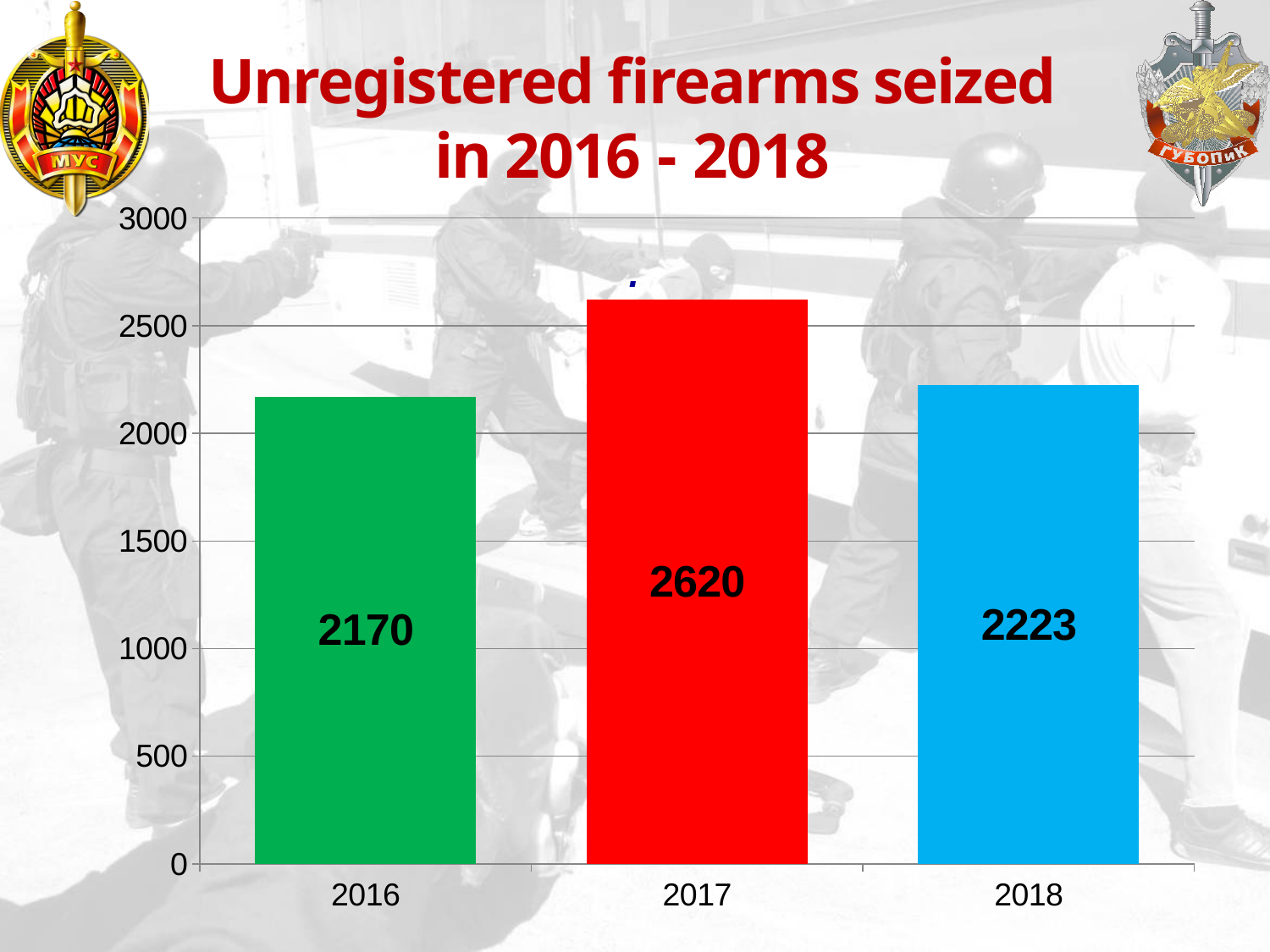
How many unregistered firearms were seized in 2018? 2223 What is the difference between the number of firearms seized in 2017 and in 2016? 450 How many unregistered firearms were seized in 2017? 2620 Which year had more unregistered firearms seized, 2016 or 2018? 2018 Is the value for 2017 greater or less than 2500? greater How many unregistered firearms were seized in 2016? 2170 What is the title of the chart? Unregistered firearms seized in 2016 - 2018 Which year had the lowest number of unregistered firearms seized? 2016 Which year had the highest number of unregistered firearms seized? 2017 What kind of chart is shown on the slide? bar chart What is the difference between the number of firearms seized in 2018 and in 2016? 53 How many years are shown on the chart? 3